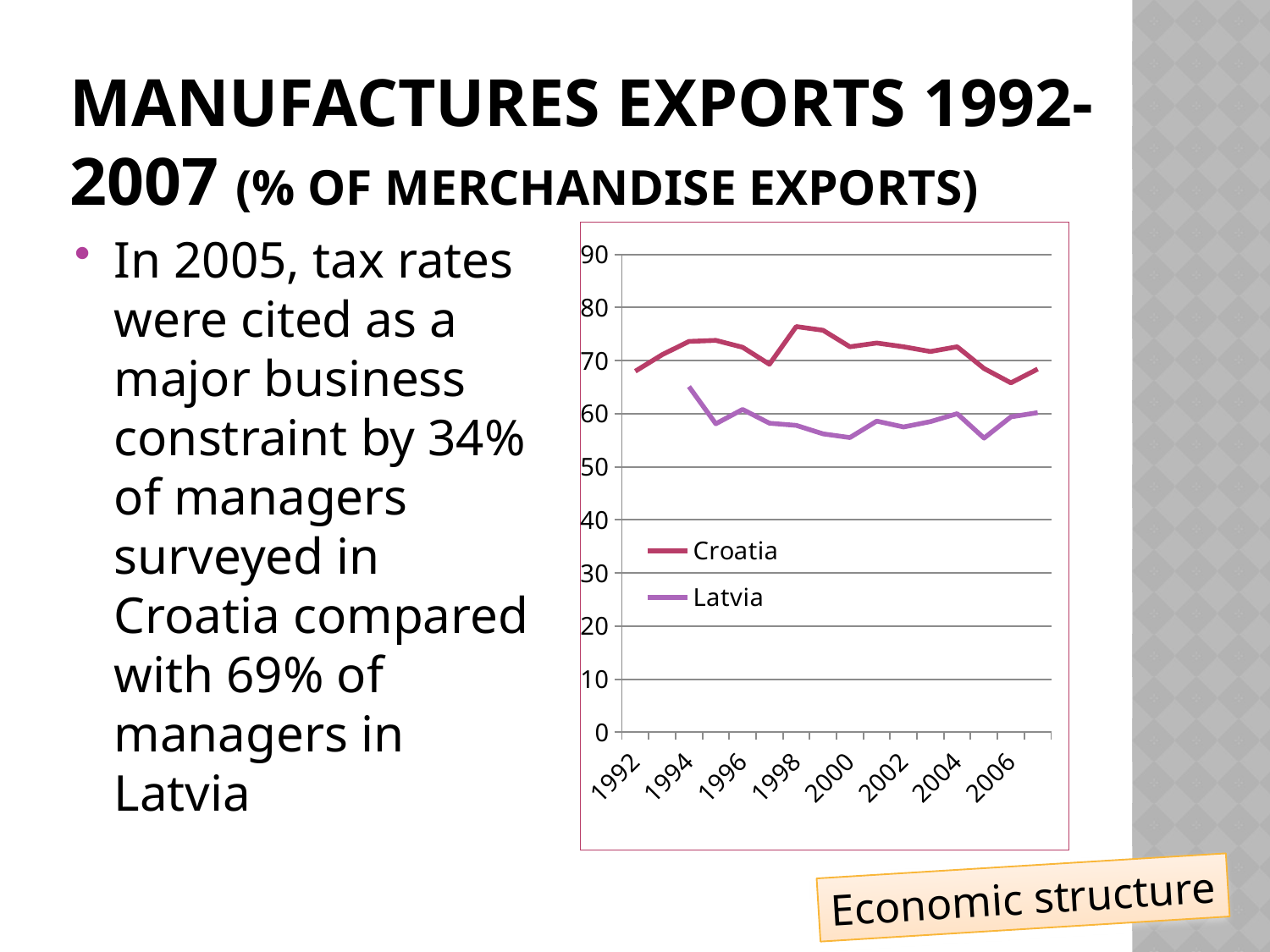
What is the highest value shown on the chart's vertical axis? 90 Does the Croatia line rise or fall between 2004 and 2006? fall Which series lies above the other across the whole period shown? Croatia Is the value for Latvia in 1994 greater or less than 60? greater Is the value for Croatia in 1998 greater or less than 70? greater How many series does the chart's legend list? 2 What kind of chart is shown on the slide? line chart Is the value for Croatia in 1992 greater or less than 60? greater Which two countries are shown in the chart's legend? Croatia and Latvia In 2000, which country has the higher value, Croatia or Latvia? Croatia